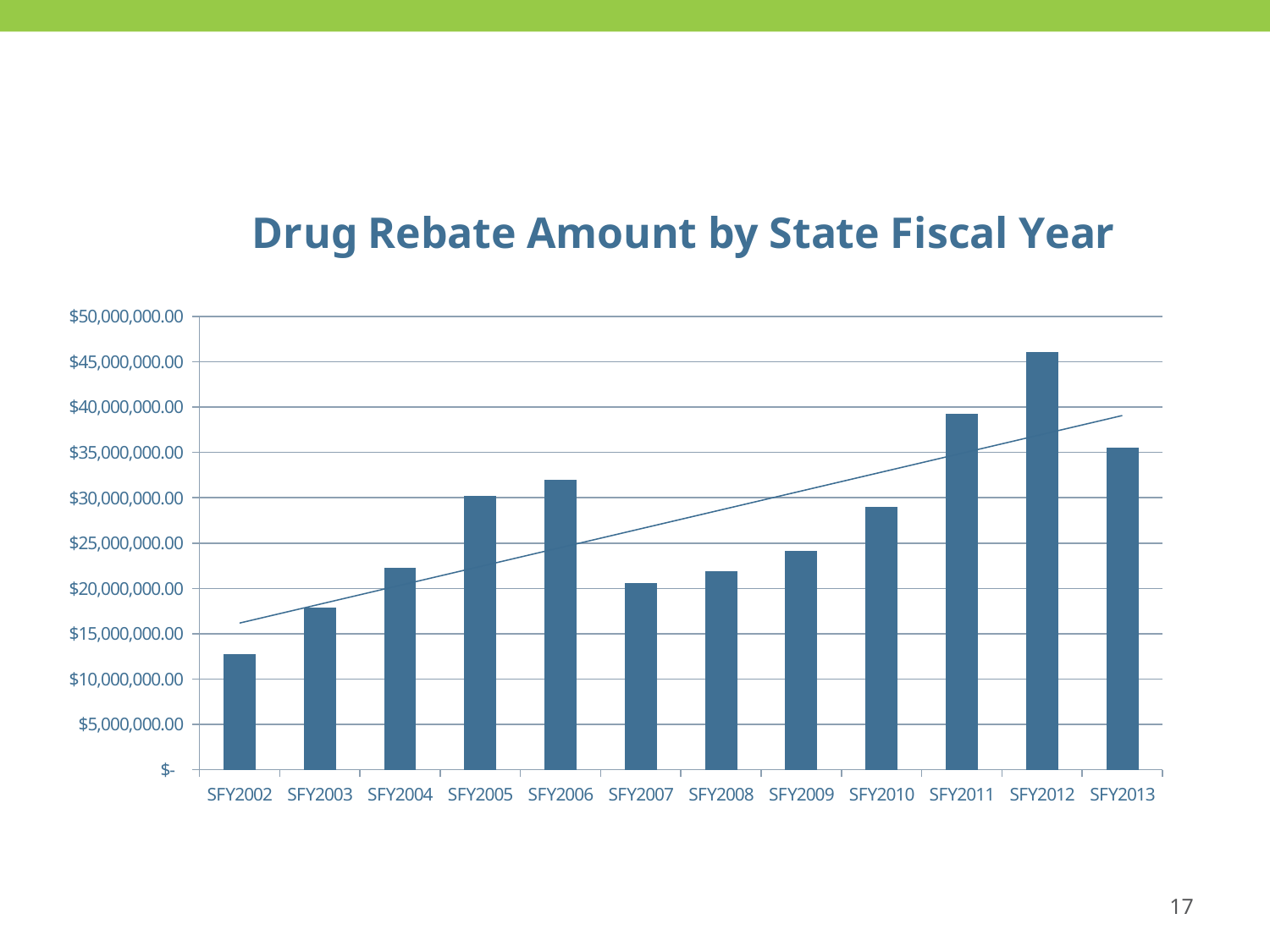
Is the drug rebate amount for SFY2007 greater or less than $25,000,000.00? less Which is larger, the drug rebate amount for SFY2003 or for SFY2007? SFY2007 What is the title of the chart? Drug Rebate Amount by State Fiscal Year What kind of chart is shown on the slide? Bar chart How many state fiscal years are shown on the x axis? 12 Which state fiscal year has the highest drug rebate amount? SFY2012 Is the drug rebate amount for SFY2013 greater or less than $30,000,000.00? greater Which is larger, the drug rebate amount for SFY2012 or for SFY2013? SFY2012 Is the drug rebate amount for SFY2011 greater or less than $35,000,000.00? greater From SFY2002 to SFY2006, do the drug rebate amounts rise or fall? Rise Which state fiscal year has the lowest drug rebate amount? SFY2002